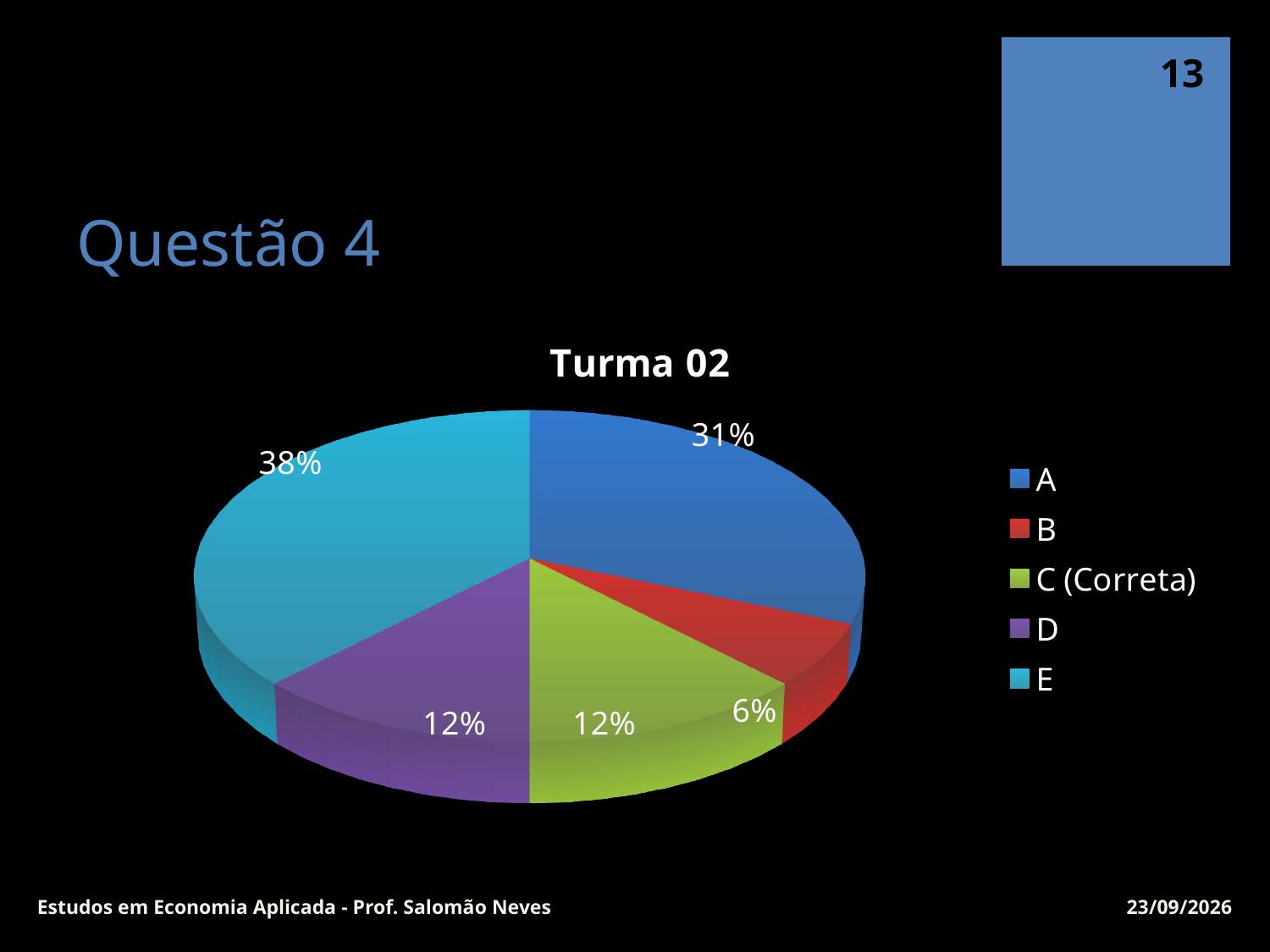
What percentage of the pie does slice C (Correta) represent? 12% What percentage of the pie does slice A represent? 31% What is the title of the chart? Turma 02 How many entries does the legend list? 5 What percentage of the pie does slice B represent? 6% Which slice has the largest share of the pie? E How many slices does the pie chart have? 5 What is the difference in percentage points between slice E and slice A? 7 Which slice has the smallest share of the pie? B What kind of chart is shown on the slide? pie chart Which slice is larger, A or D? A What percentage of the pie does slice E represent? 38%